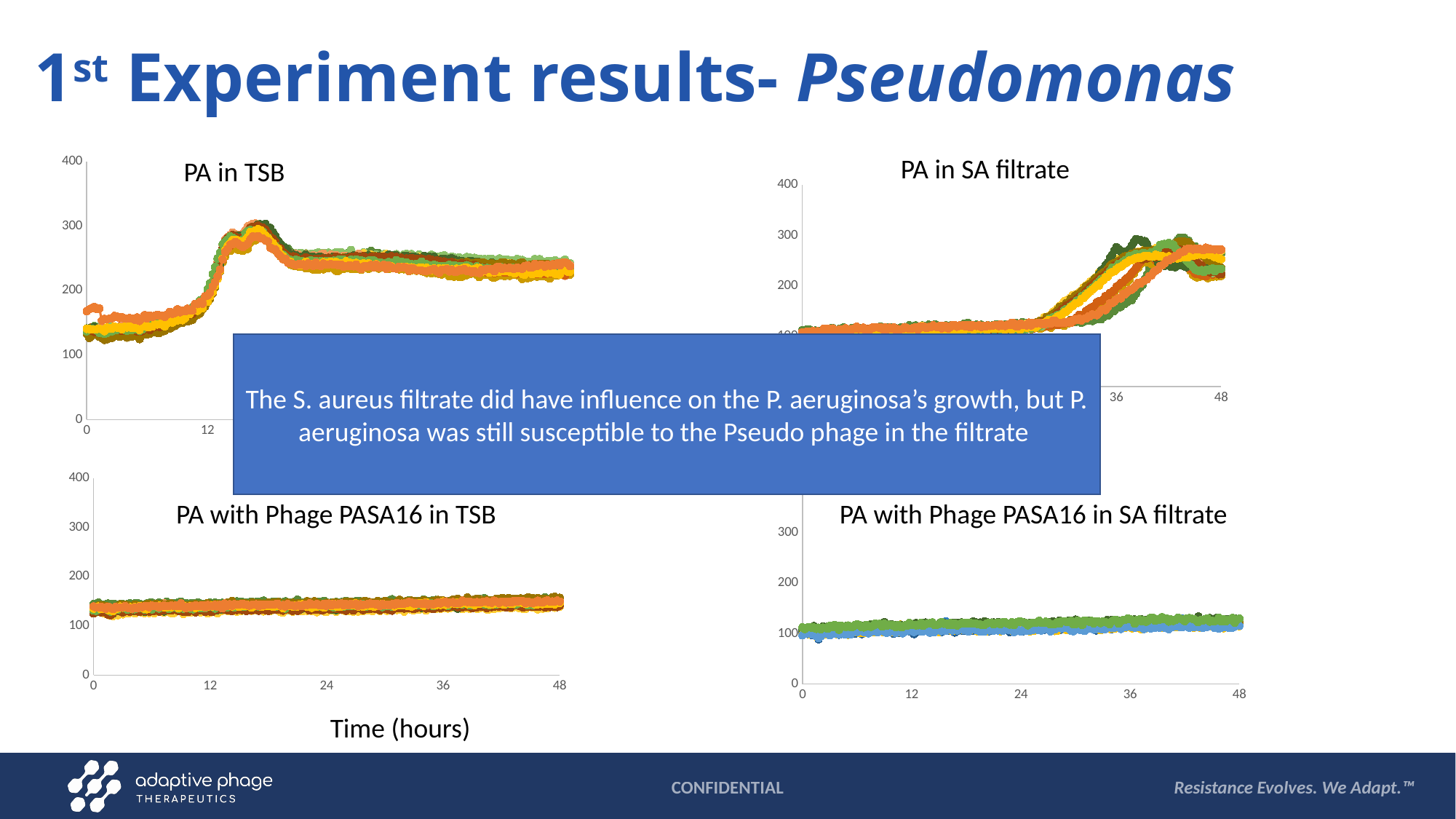
In the 'PA in TSB' chart, is the value at 0 hours greater or less than 200? less In the 'PA in SA filtrate' chart, is the value at 24 hours greater or less than 200? less In the 'PA in SA filtrate' chart, do the values rise or fall between 24 and 40 hours? rise In the 'PA in SA filtrate' chart, is the value at 48 hours greater or less than 200? greater How many charts are shown on the slide? 4 In the 'PA with Phage PASA16 in TSB' chart, do the values rise sharply, fall sharply, or stay roughly flat between 0 and 48 hours? stay roughly flat What is the title of the chart in the top-left of the slide? PA in TSB At 48 hours, which is larger: the value in the 'PA in TSB' chart or the value in the 'PA with Phage PASA16 in TSB' chart? PA in TSB What label is given to the x axis of the charts? Time (hours)